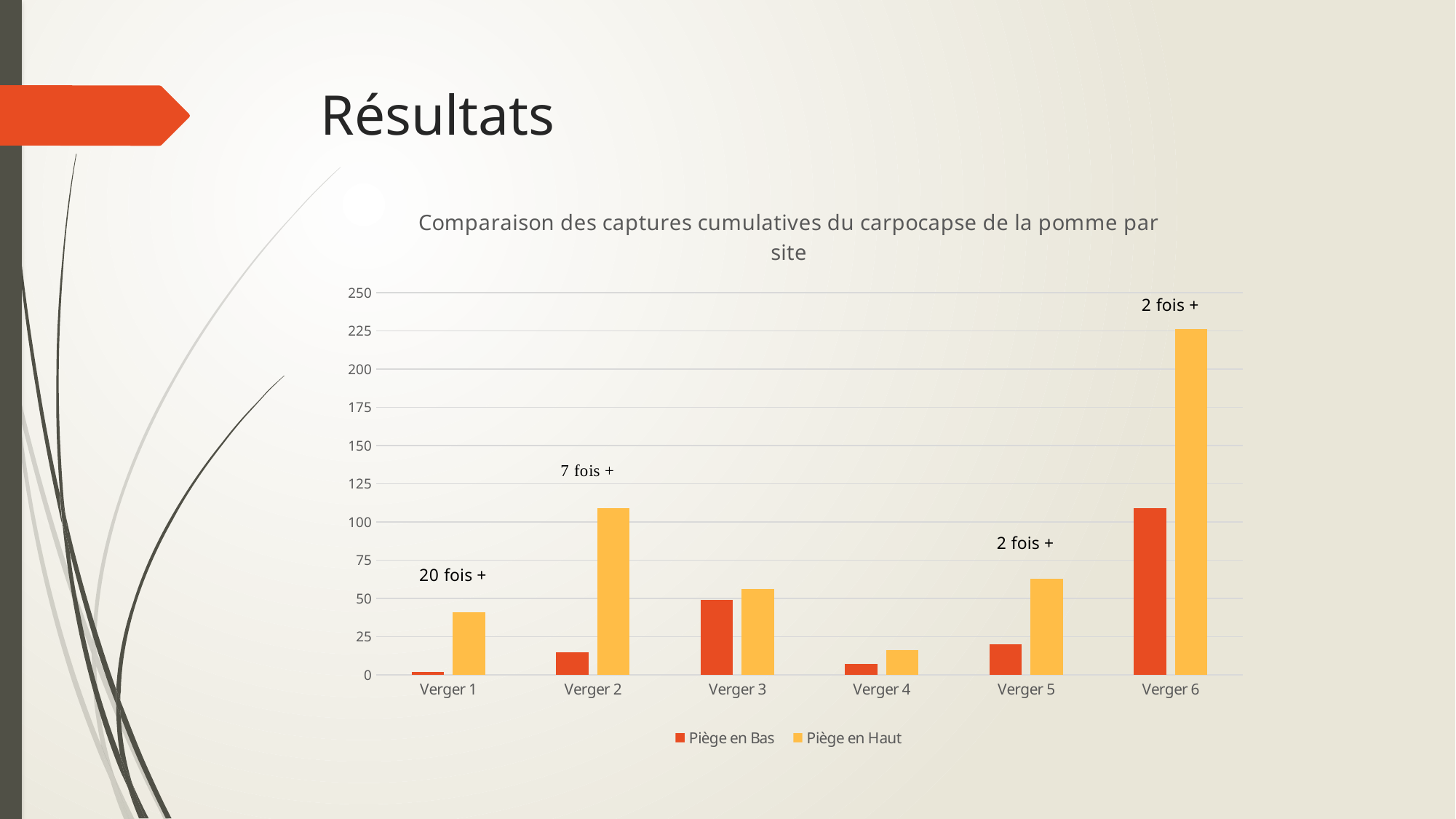
Which site has the highest value for Piège en Haut? Verger 6 Is the Piège en Haut value for Verger 1 greater or less than 50? less Which site has the lowest value for Piège en Haut? Verger 4 Which is larger: the Piège en Haut value for Verger 2 or the Piège en Haut value for Verger 5? Verger 2 Is the Piège en Haut value for Verger 4 greater or less than 25? less Is the Piège en Haut value for Verger 6 greater or less than 200? greater What kind of chart is shown on the slide? bar chart How many sites (vergers) are shown on the x axis of the chart? 6 Which site has the highest value for Piège en Bas? Verger 6 How many series does the chart legend list? 2 What annotation is written above the bars for Verger 1? 20 fois + Which site has the lowest value for Piège en Bas? Verger 1